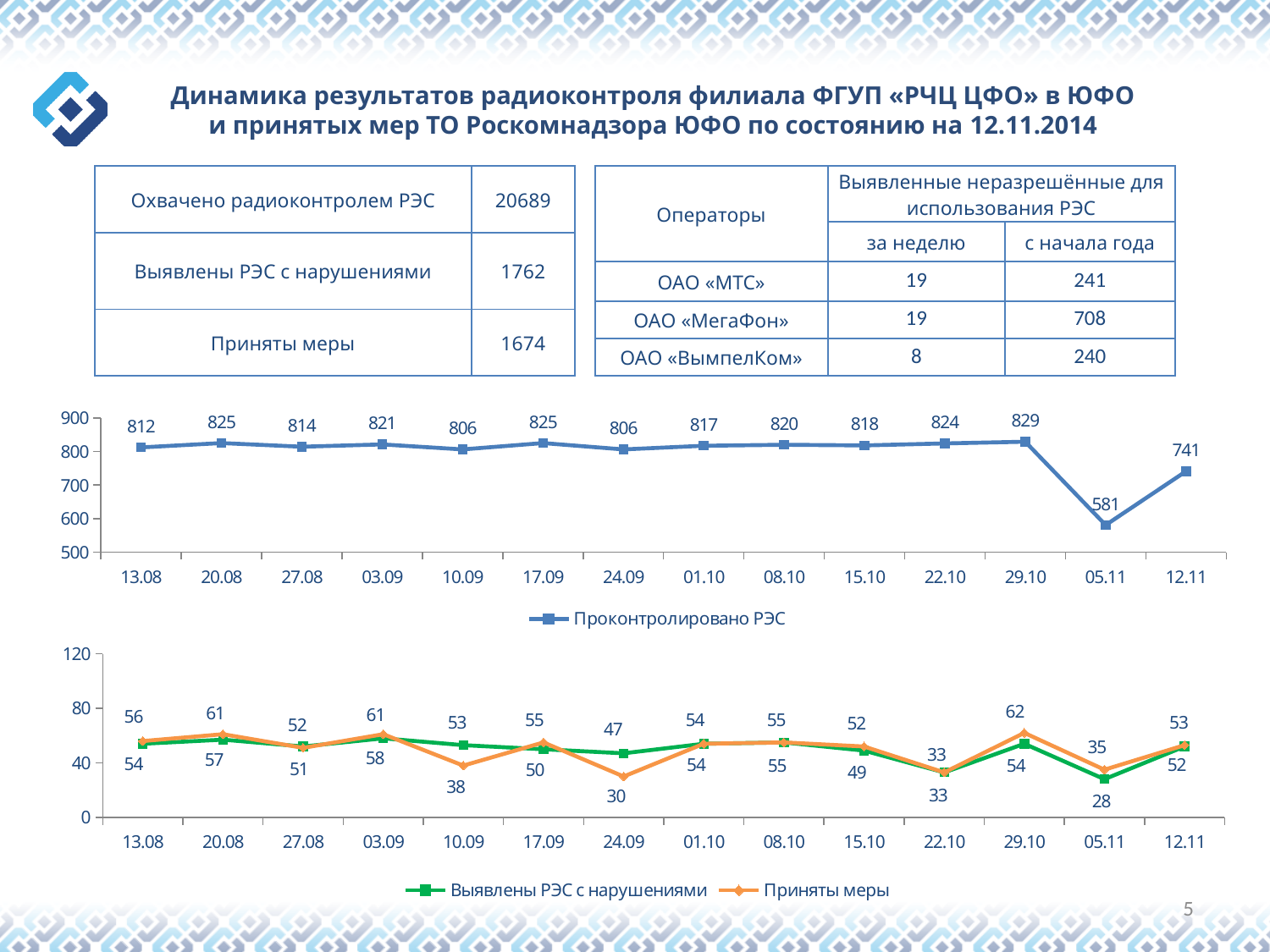
In the top chart (Проконтролировано РЭС), what is the value for 05.11? 581 How many series does the legend of the bottom chart list? 2 How many data points are plotted in the top chart (Проконтролировано РЭС)? 14 In the bottom chart, what is the value of Выявлены РЭС с нарушениями for 10.09? 53 In the top chart (Проконтролировано РЭС), what is the difference between the values for 29.10 and 05.11? 248 In the bottom chart, which series has the larger value on 10.09: Выявлены РЭС с нарушениями or Приняты меры? Выявлены РЭС с нарушениями What type of chart is the top chart on the slide? line chart In the bottom chart, what is the value of Приняты меры for 24.09? 30 In the top chart, is the value for 12.11 greater or less than 800? less In the top chart (Проконтролировано РЭС), what is the value for 29.10? 829 In the top chart (Проконтролировано РЭС), which date has the lowest value? 05.11 In the top chart (Проконтролировано РЭС), which date has the highest value? 29.10